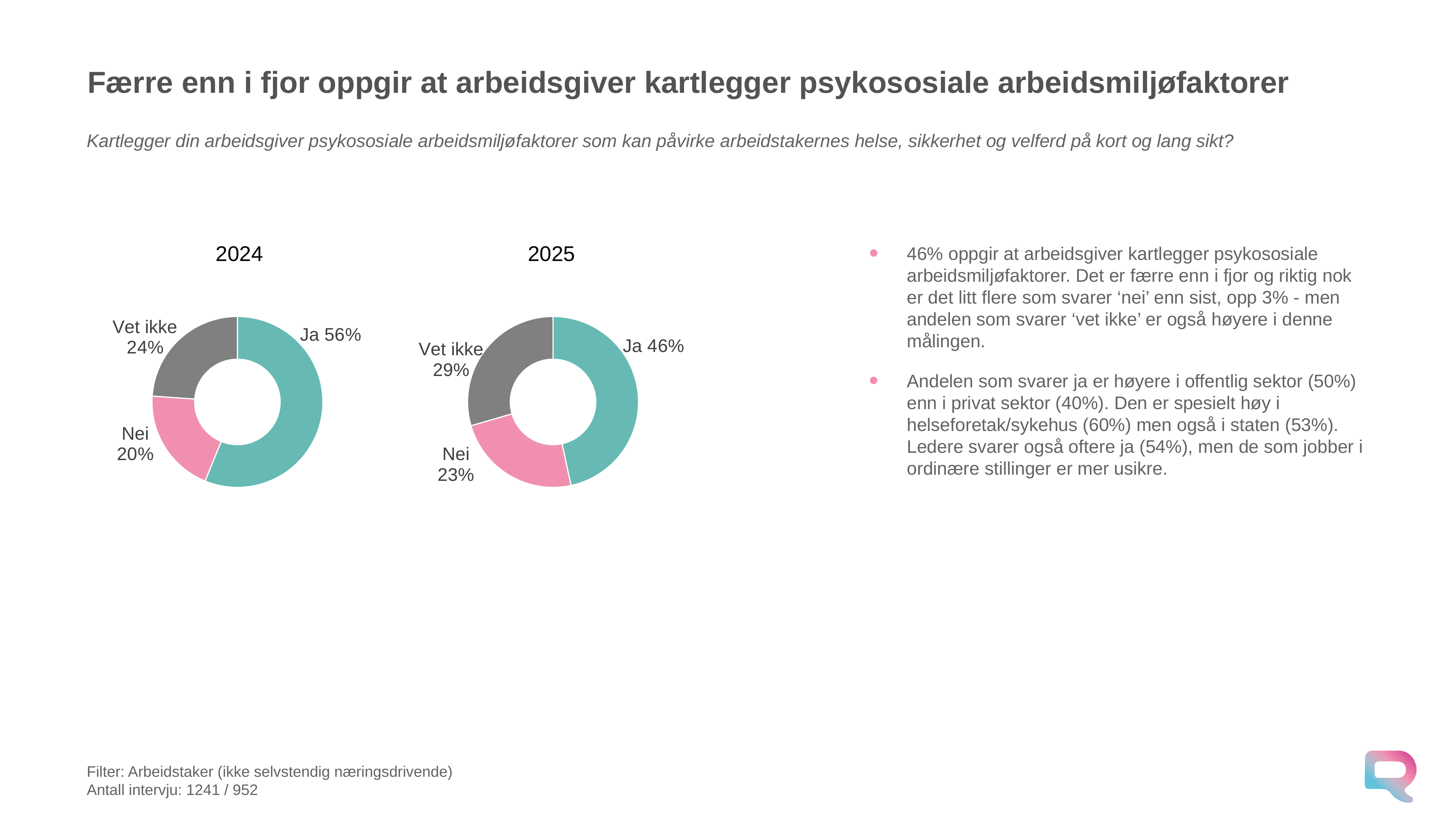
What is the difference between the 'Ja' share in the 2024 chart and the 'Ja' share in the 2025 chart? 10% In the 2024 chart, what colour is the 'Vet ikke' segment? Grey In the 2025 chart, what is the value for 'Vet ikke'? 29% In the 2024 chart, which category has the largest share? Ja How many categories does the 2024 chart show? 3 What type of chart is used for the 2025 data? Donut chart In the 2025 chart, what share of respondents answered 'Ja'? 46% In the 2025 chart, what is the difference between 'Vet ikke' and 'Nei'? 6% In the 2024 chart, what is the value for 'Nei'? 20% In the 2024 chart, what share of respondents answered 'Ja'? 56% In the 2025 chart, which category has the smallest share? Nei Is the 'Nei' share larger in the 2024 chart or the 2025 chart? 2025